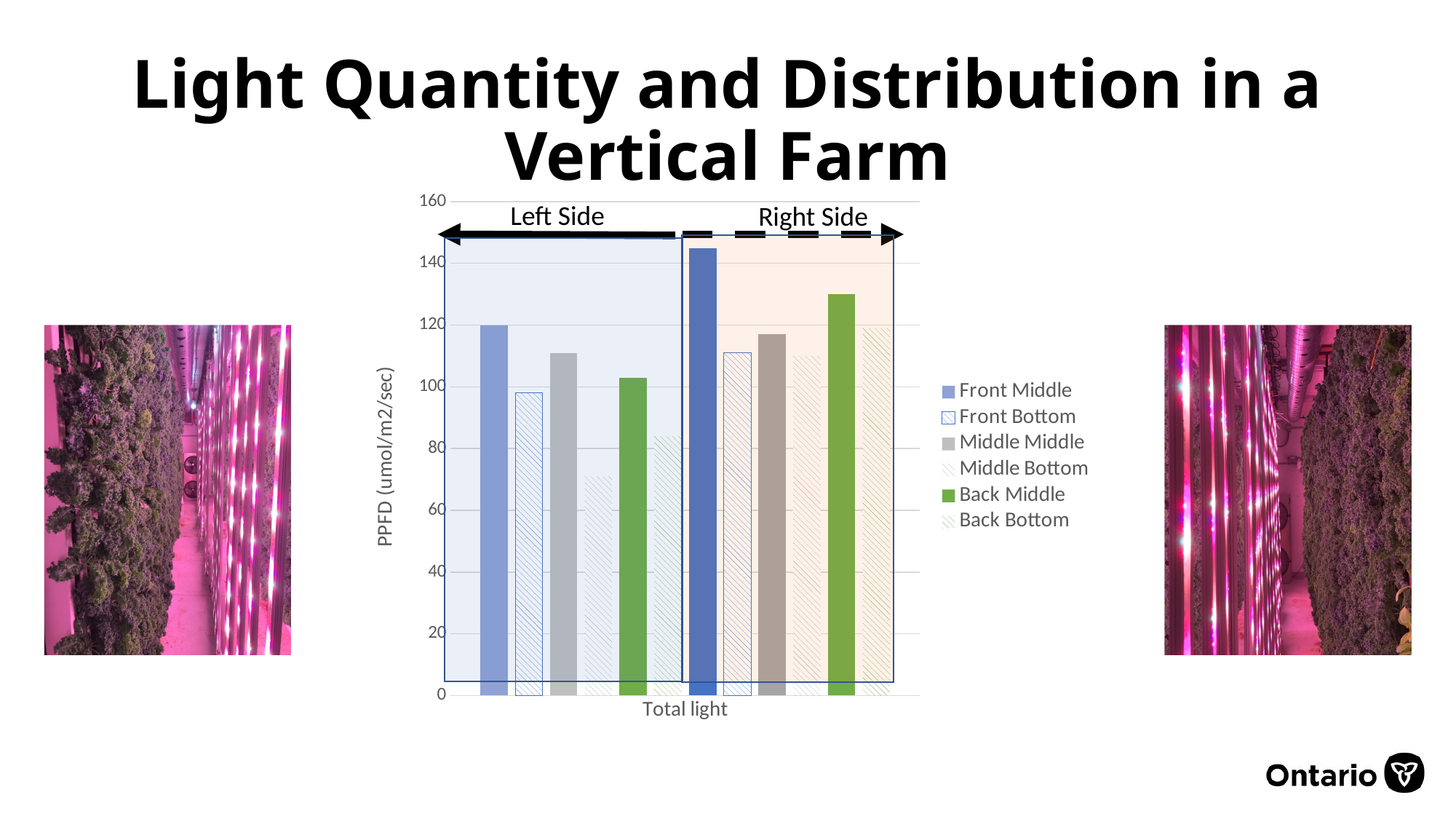
Is the Middle Bottom value on the Left Side greater or less than 80? less Is the Back Middle value on the Right Side greater or less than 120? greater What is the y-axis title of the chart? PPFD (umol/m2/sec) Is the Front Middle value on the Right Side greater or less than 140? greater On the Right Side, which is larger: Back Middle or Middle Middle? Back Middle Which is larger: the Front Middle value on the Left Side or the Front Middle value on the Right Side? Right Side Which bar on the chart is the lowest overall? Middle Bottom on the Left Side What are the two groups of bars labelled on the chart? Left Side and Right Side What kind of chart is shown on the slide? bar chart Which bar on the chart is the highest overall? Front Middle on the Right Side How many series does the chart legend list? 6